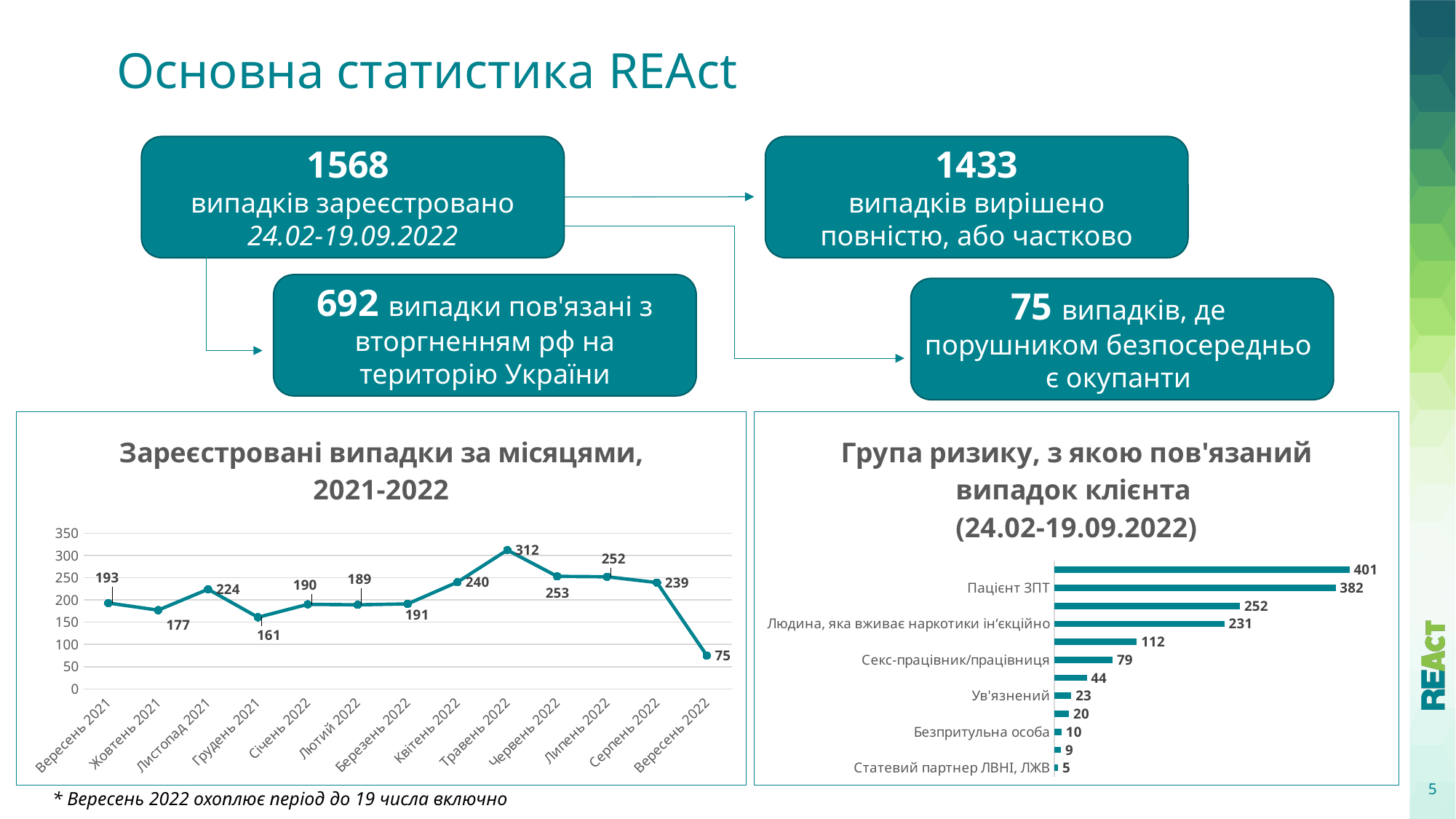
In the chart 'Зареєстровані випадки за місяцями, 2021-2022', which is larger: Листопад 2021 or Грудень 2021? Листопад 2021 In the chart 'Зареєстровані випадки за місяцями, 2021-2022', which month has the highest value? Травень 2022 In the chart 'Група ризику, з якою пов'язаний випадок клієнта', which is larger: Секс-працівник/працівниця or Ув'язнений? Секс-працівник/працівниця What kind of chart is 'Група ризику, з якою пов'язаний випадок клієнта'? Bar chart In the chart 'Група ризику, з якою пов'язаний випадок клієнта', what is the value for Статевий партнер ЛВНІ, ЛЖВ? 5 In the chart 'Зареєстровані випадки за місяцями, 2021-2022', which month has the lowest value? Вересень 2022 In the chart 'Зареєстровані випадки за місяцями, 2021-2022', do the values rise or fall from Серпень 2022 to Вересень 2022? Fall In the chart 'Зареєстровані випадки за місяцями, 2021-2022', what is the difference between Травень 2022 and Червень 2022? 59 In the chart 'Група ризику, з якою пов'язаний випадок клієнта', what is the value for Пацієнт ЗПТ? 382 In the chart 'Зареєстровані випадки за місяцями, 2021-2022', how many months are plotted? 13 What kind of chart is 'Зареєстровані випадки за місяцями, 2021-2022'? Line chart In the chart 'Зареєстровані випадки за місяцями, 2021-2022', what is the value for Травень 2022? 312